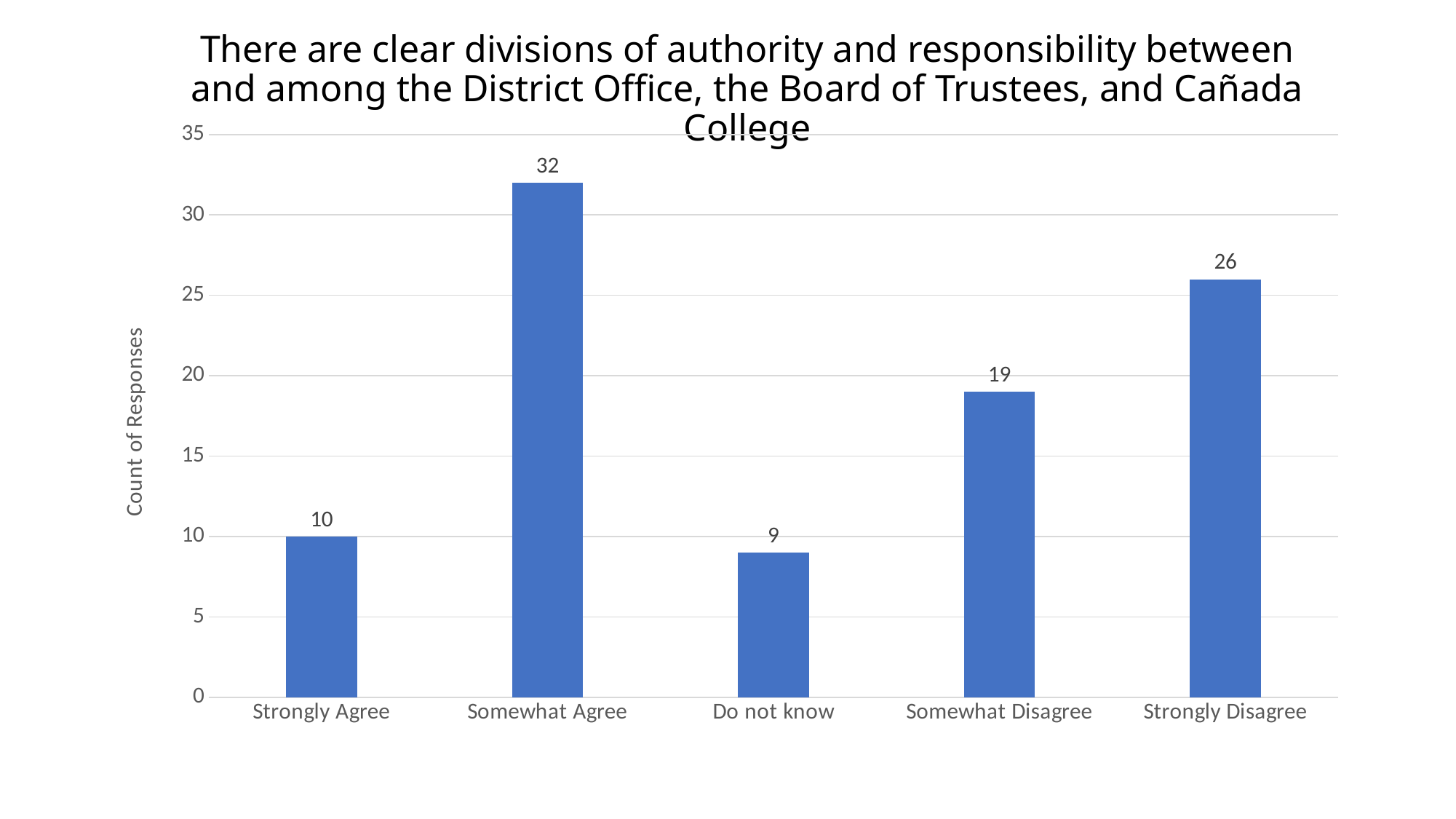
What kind of chart is shown on the slide? bar chart Which response category has the lowest count? Do not know Which response category has the highest count? Somewhat Agree What is the difference between the counts for Somewhat Disagree and Strongly Agree? 9 How many response categories are shown on the x axis? 5 Is the value for Somewhat Disagree greater or less than 20? less What is the difference between the counts for Somewhat Agree and Strongly Disagree? 6 What is the count of responses for Do not know? 9 What is the label of the vertical axis? Count of Responses Which has a larger count, Somewhat Disagree or Strongly Disagree? Strongly Disagree What is the count of responses for Somewhat Agree? 32 What is the count of responses for Strongly Disagree? 26